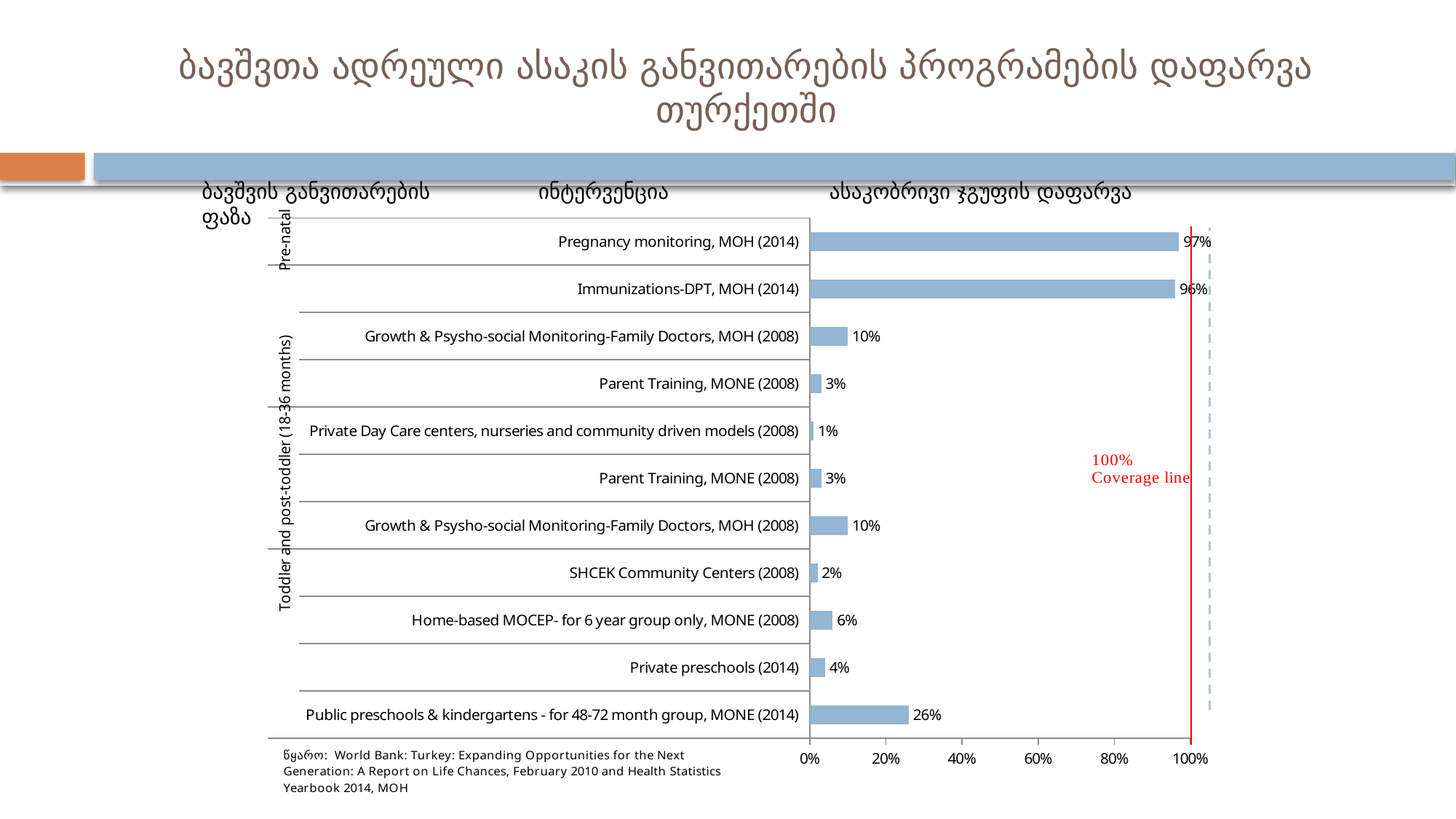
Which has a larger coverage value: SHCEK Community Centers (2008) or Private preschools (2014)? Private preschools (2014) What is the coverage value for Pregnancy monitoring, MOH (2014)? 97% What type of chart is shown on the slide? Bar chart What is the coverage value for Public preschools & kindergartens - for 48-72 month group, MONE (2014)? 26% What is the difference between the coverage for Public preschools & kindergartens - for 48-72 month group, MONE (2014) and Private preschools (2014)? 22% What is the coverage value for Home-based MOCEP- for 6 year group only, MONE (2008)? 6% How many categories (bars) are shown in the chart? 11 What is the difference between the coverage for Pregnancy monitoring, MOH (2014) and Immunizations-DPT, MOH (2014)? 1% Which category has the lowest coverage value? Private Day Care centers, nurseries and community driven models (2008) Is the coverage value for Public preschools & kindergartens - for 48-72 month group, MONE (2014) greater or less than 20%? greater What is the coverage value for Immunizations-DPT, MOH (2014)? 96% Which category has the highest coverage value? Pregnancy monitoring, MOH (2014)